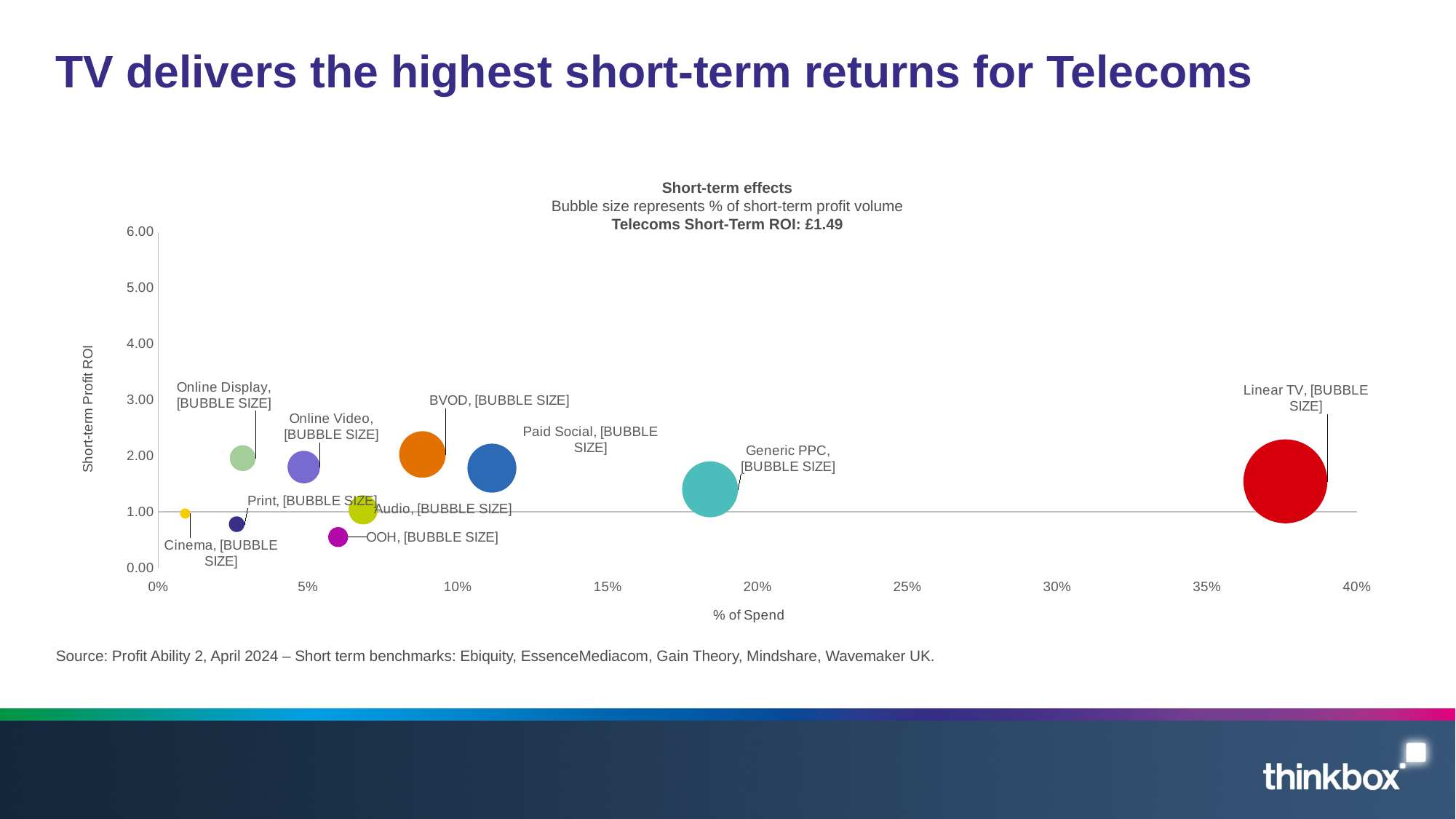
Is the % of spend for Linear TV greater or less than 35%? greater Which has the larger % of spend, Linear TV or Generic PPC? Linear TV Is the short-term profit ROI for Online Display greater or less than 3.00? less Which channel has the lowest % of spend? Cinema Which has the higher short-term profit ROI, Online Display or Print? Online Display Which channel has the highest % of spend? Linear TV Which channel has the lowest short-term profit ROI? OOH What kind of chart is shown on the slide? Bubble chart Is the short-term profit ROI for OOH greater or less than 1.00? less How many media channels (bubbles) are plotted on the chart? 10 What Telecoms short-term ROI figure is stated in the chart title? £1.49